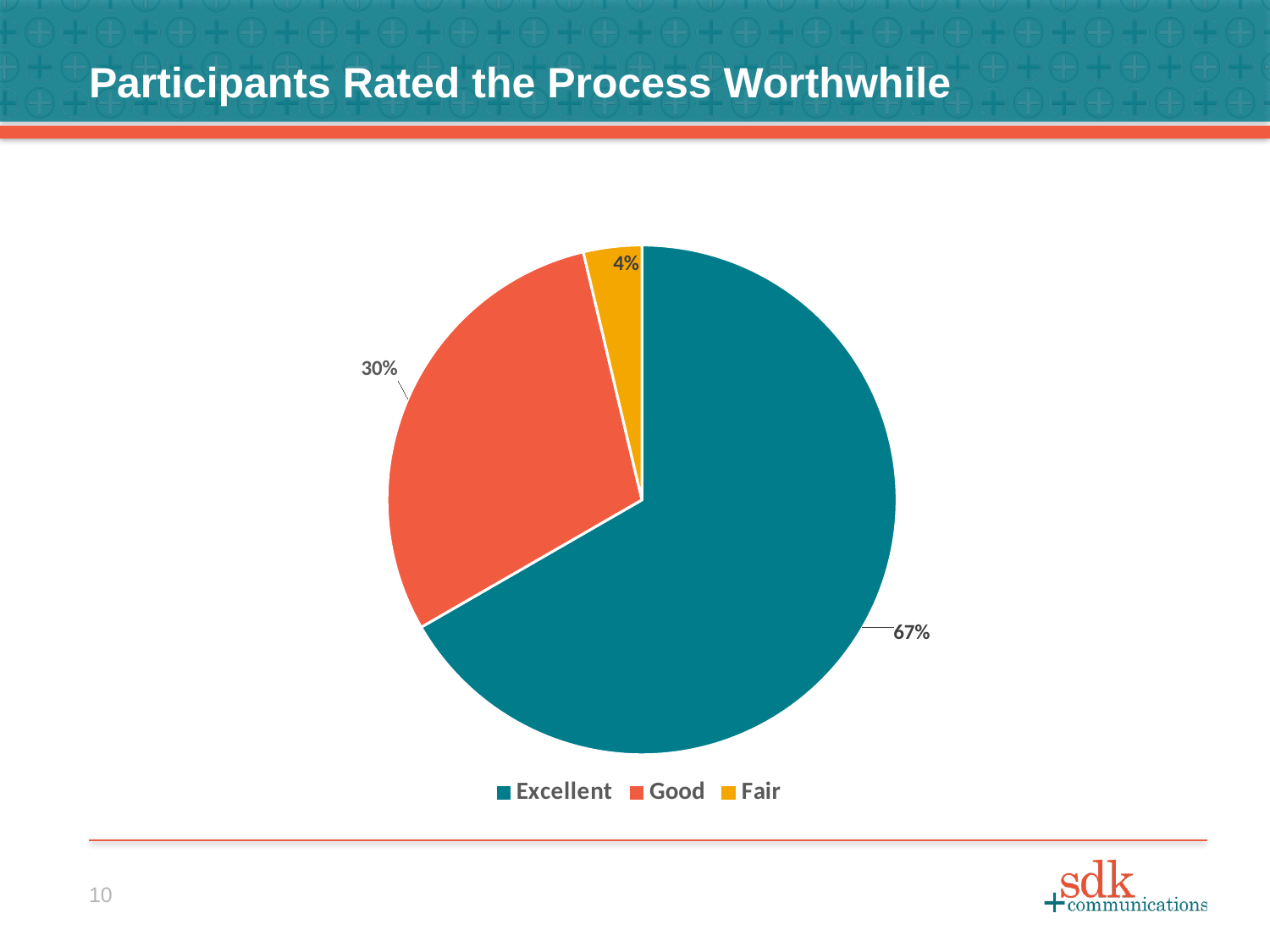
Which rating has the smallest slice of the pie? Fair What colour is the Good slice in the pie chart? orange-red What is the difference in percentage points between the Good and Fair slices? 26 What share of participants rated the process Excellent? 67% What is the title of the slide containing the pie chart? Participants Rated the Process Worthwhile Which rating has the largest slice of the pie? Excellent What share of participants rated the process Good? 30% What is the difference in percentage points between the Excellent and Good slices? 37 What share of participants rated the process Fair? 4% What kind of chart is shown on the slide? pie chart How many categories does the pie chart show? 3 Which slice is larger, Good or Fair? Good